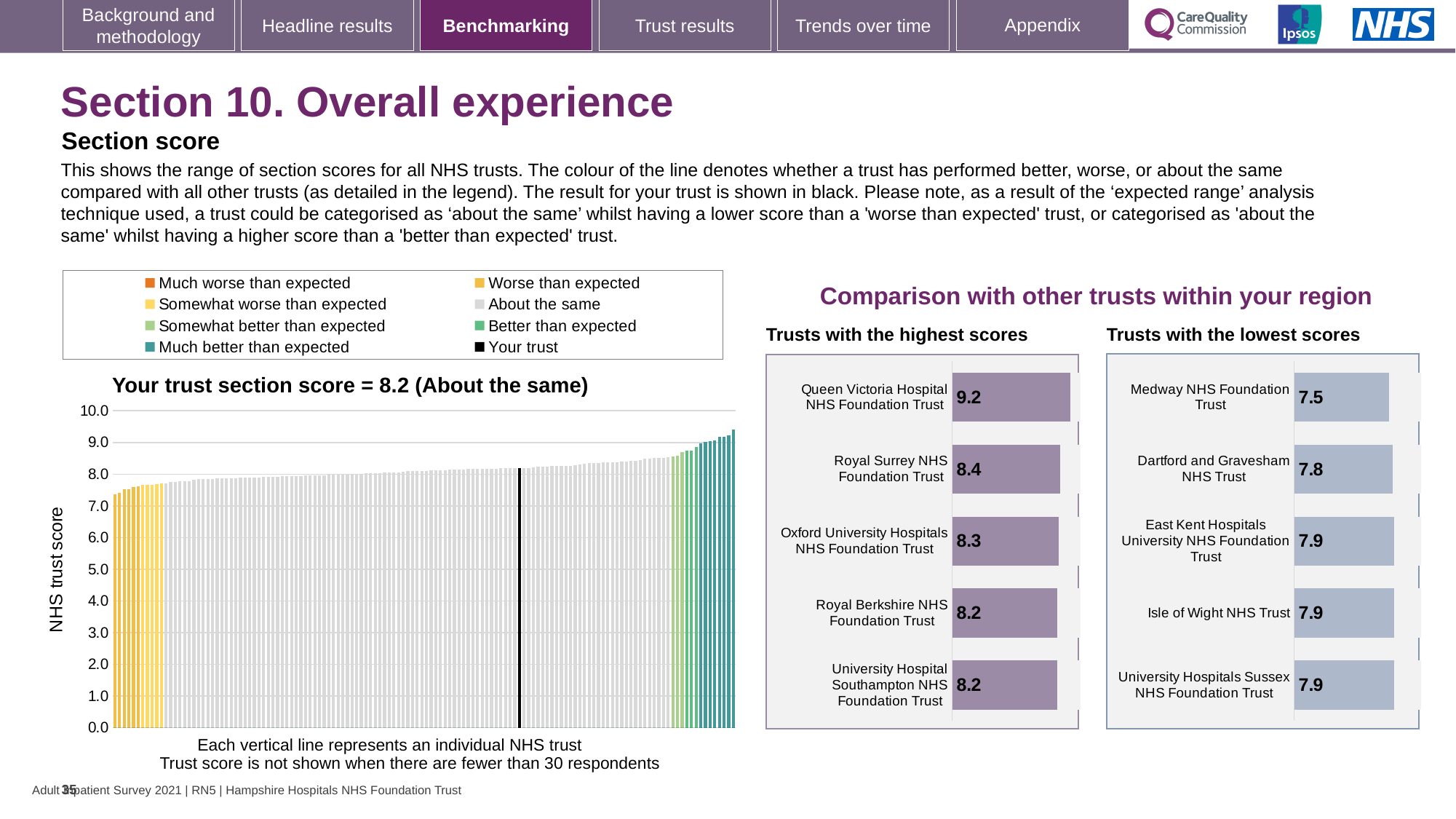
How many entries does the legend above the 'Your trust section score' chart list? 8 In the 'Trusts with the lowest scores' chart, what is the score for Dartford and Gravesham NHS Trust? 7.8 In the 'Trusts with the lowest scores' chart, which trust has the lowest score? Medway NHS Foundation Trust In the 'Trusts with the highest scores' chart, how many trusts are listed? 5 In the 'Trusts with the highest scores' chart, which trust has the highest score? Queen Victoria Hospital NHS Foundation Trust In the 'Your trust section score' chart, is the value of the lowest (leftmost) bar greater or less than 8.0? less In the 'Trusts with the highest scores' chart, what is the difference between the scores of Queen Victoria Hospital NHS Foundation Trust and Royal Surrey NHS Foundation Trust? 0.8 In the 'Trusts with the lowest scores' chart, which has the larger score: Medway NHS Foundation Trust or Isle of Wight NHS Trust? Isle of Wight NHS Trust What kind of chart is the 'Your trust section score' chart? bar chart In the 'Your trust section score' chart, is the value of the highest (rightmost) bar greater or less than 9.0? greater In the 'Your trust section score' chart, what is the section score for your trust? 8.2 In the 'Trusts with the highest scores' chart, what is the score for Queen Victoria Hospital NHS Foundation Trust? 9.2